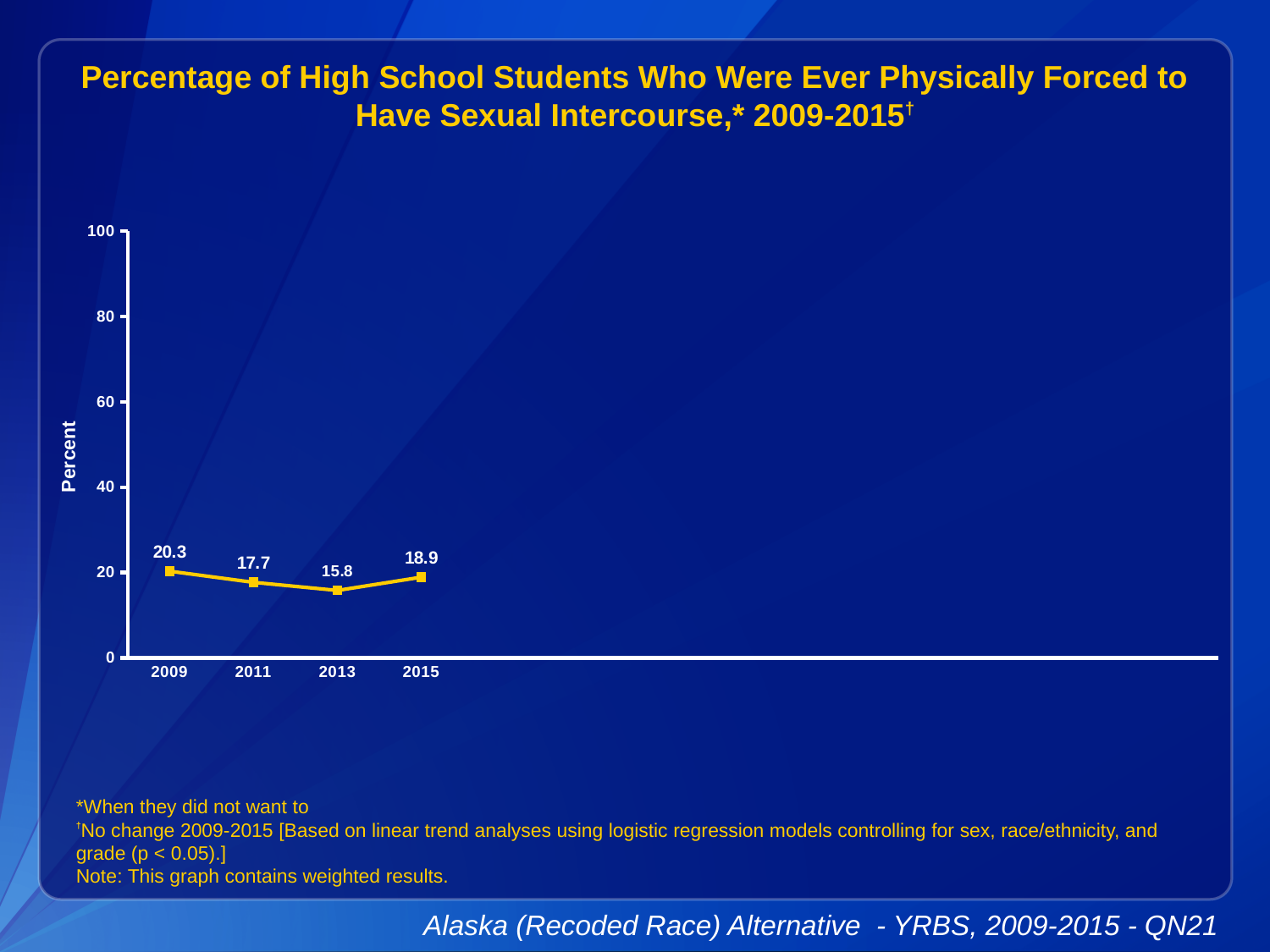
Which is larger, the value for 2011 or the value for 2015? 2015 What kind of chart is shown? line chart What is the value for 2013? 15.8 How many years are plotted on the chart? 4 Which year has the lowest value? 2013 What is the value for 2015? 18.9 What is the difference between the values for 2009 and 2013? 4.5 What is the label on the y axis? Percent Which year has the highest value? 2009 Does the value rise or fall from 2013 to 2015? rise What is the value for 2009? 20.3 Is the value for 2011 greater or less than 20? less